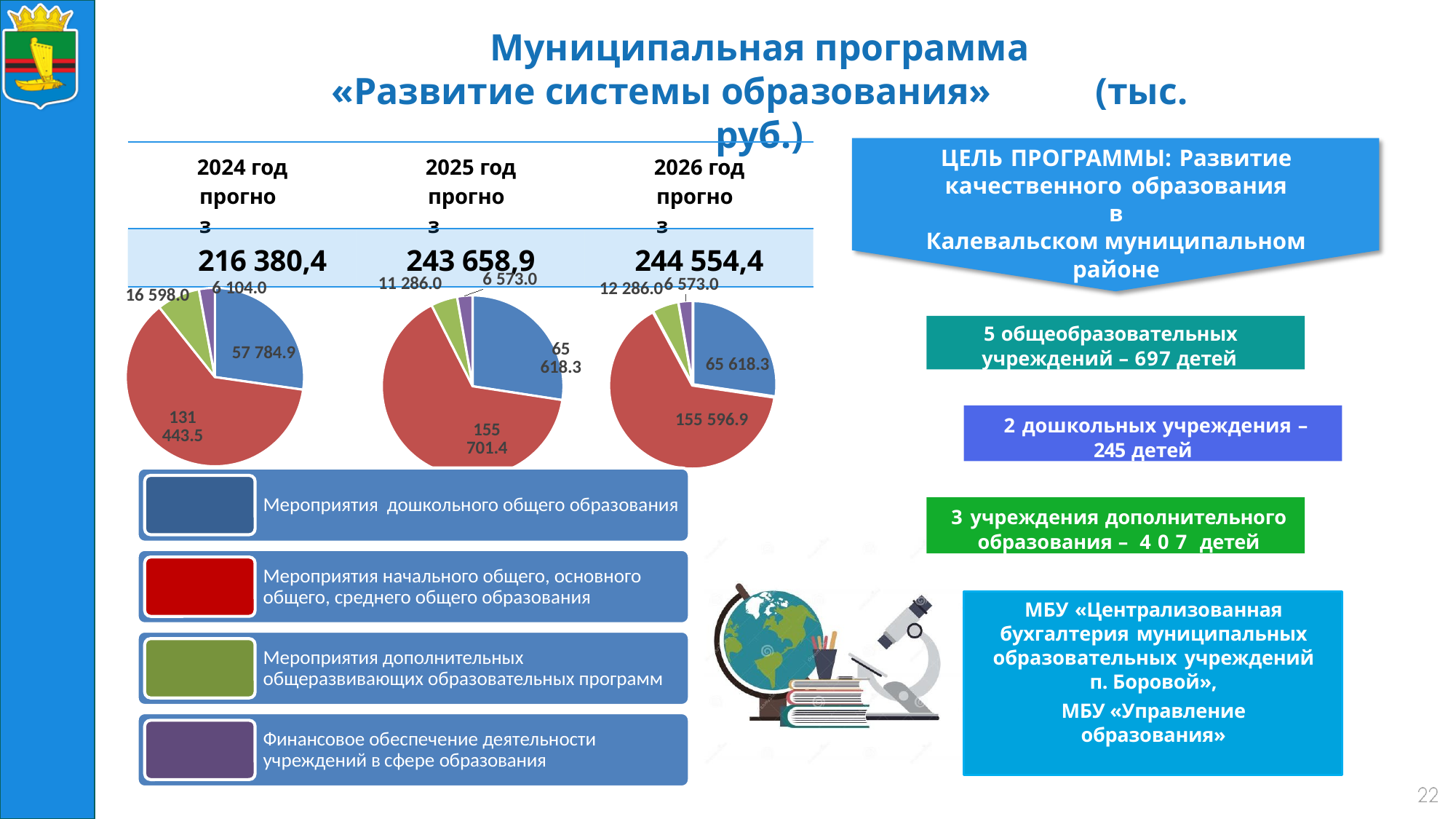
What colour represents Финансовое обеспечение деятельности учреждений в сфере образования in the pie charts? Purple In the 2024 год прогноз pie chart, what is the value of the red slice (Мероприятия начального общего, основного общего, среднего общего образования)? 131 443.5 What type of charts are shown on the slide? Pie charts In the 2024 год прогноз pie chart, which category has the largest slice? Мероприятия начального общего, основного общего, среднего общего образования In the 2026 год прогноз pie chart, what is the value of the green slice (Мероприятия дополнительных общеразвивающих образовательных программ)? 12 286.0 In the 2025 год прогноз pie chart, what is the value of the blue slice (Мероприятия дошкольного общего образования)? 65 618.3 What is the difference between the red slice values in the 2025 and 2026 pie charts? 104.5 Which is larger: the green slice in the 2024 pie chart or the green slice in the 2025 pie chart? 2024 (16 598.0) How many pie charts are on the slide? 3 In the 2026 год прогноз pie chart, which category has the smallest slice? Финансовое обеспечение деятельности учреждений в сфере образования How many categories does the legend below the pie charts list? 4 What is the total shown above the 2025 год прогноз pie chart? 243 658,9